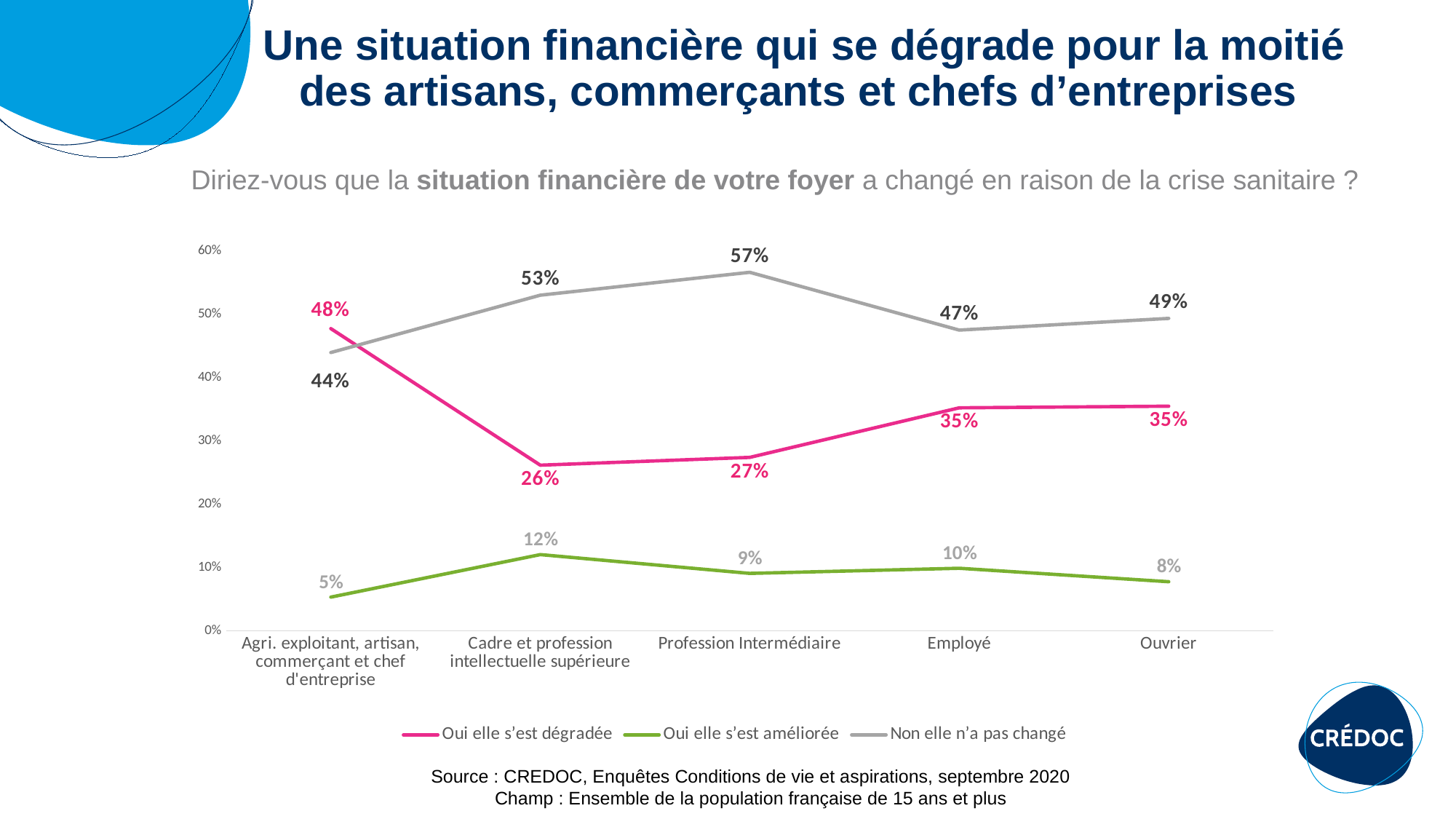
For "Employé", which is larger: "Oui elle s'est dégradée" or "Non elle n'a pas changé"? Non elle n'a pas changé Which category has the lowest value for "Oui elle s'est améliorée"? Agri. exploitant, artisan, commerçant et chef d'entreprise How many categories are shown on the x axis? 5 Does the "Oui elle s'est dégradée" series rise or fall from "Profession Intermédiaire" to "Employé"? Rise What type of chart is shown on the slide? Line chart How many series does the legend list? 3 What is the value of "Non elle n'a pas changé" for "Profession Intermédiaire"? 57% What is the difference between the "Oui elle s'est dégradée" values for "Agri. exploitant, artisan, commerçant et chef d'entreprise" and "Cadre et profession intellectuelle supérieure"? 22 percentage points What is the value of "Oui elle s'est améliorée" for "Cadre et profession intellectuelle supérieure"? 12% What is the value of "Oui elle s'est dégradée" for "Agri. exploitant, artisan, commerçant et chef d'entreprise"? 48% What colour is the line for "Oui elle s'est améliorée"? Green Which category has the highest value for "Non elle n'a pas changé"? Profession Intermédiaire